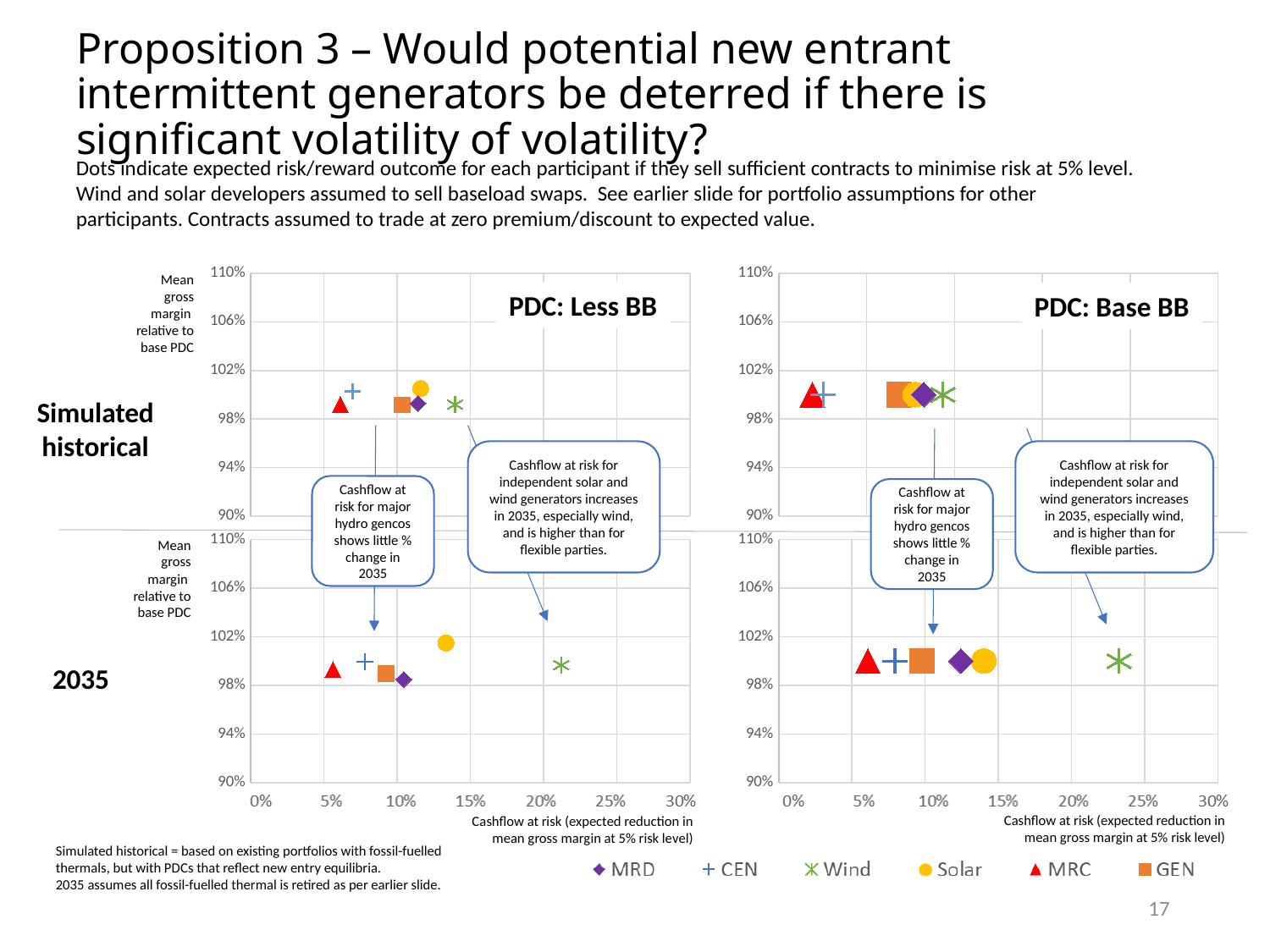
In the 2035 PDC: Base BB chart, which series has the highest cashflow at risk? Wind How many series does the legend list? 6 What is the x-axis label of the charts? Cashflow at risk (expected reduction in mean gross margin at 5% risk level) What kind of chart is used on this slide? scatter chart How many charts are shown on the slide? 4 In the 2035 PDC: Less BB chart, which series has the highest cashflow at risk? Wind In the 2035 PDC: Less BB chart, is the cashflow at risk for Wind greater or less than 15%? greater In the simulated historical PDC: Base BB chart, is the cashflow at risk for MRC greater or less than 5%? less In the 2035 PDC: Less BB chart, which has the higher mean gross margin relative to base PDC, Solar or MRD? Solar In the 2035 PDC: Less BB chart, which series has the lowest cashflow at risk? MRC In the 2035 PDC: Base BB chart, which has the higher cashflow at risk, Wind or Solar? Wind In the 2035 PDC: Base BB chart, is the cashflow at risk for Wind greater or less than 20%? greater